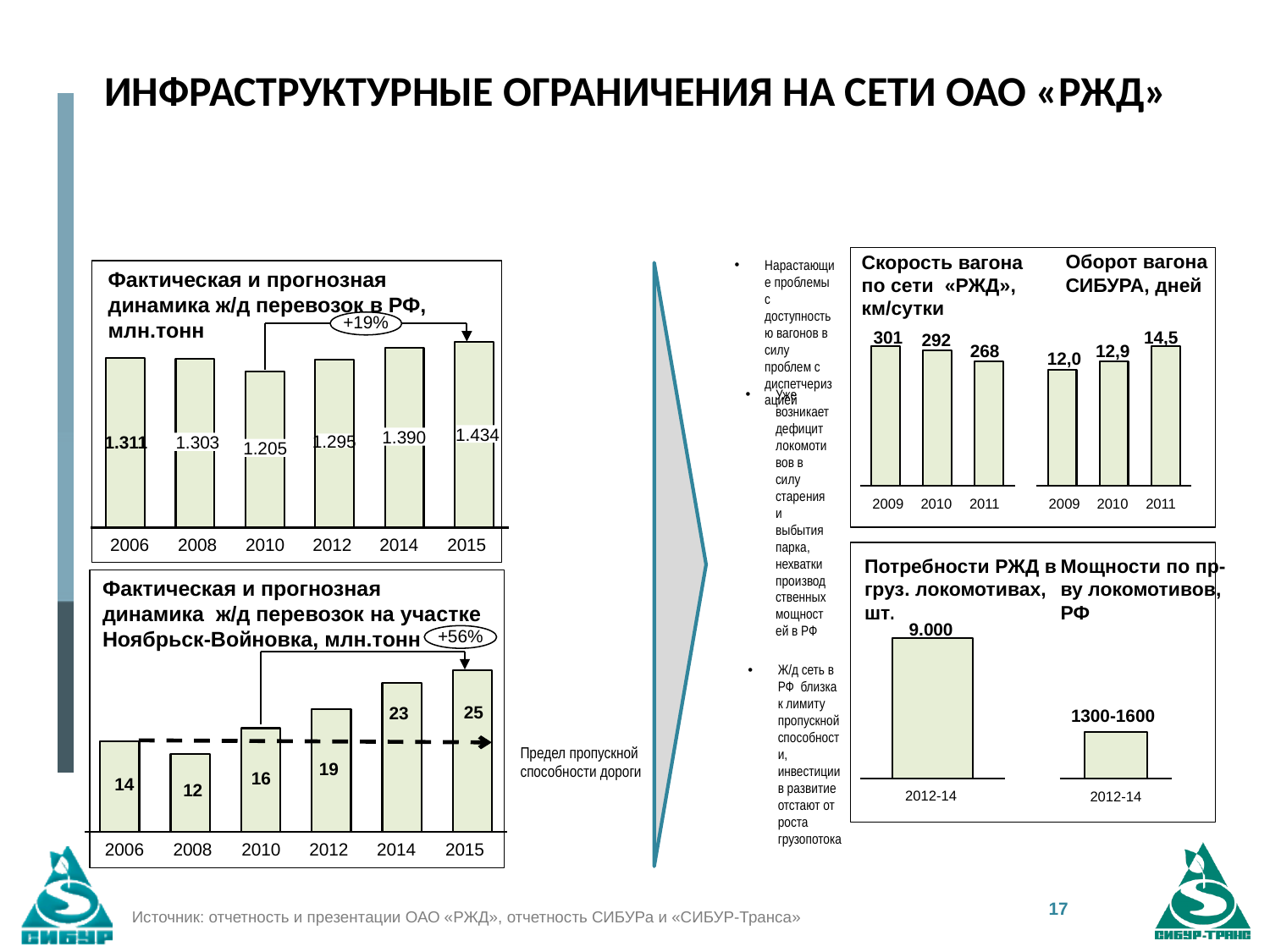
In the chart 'Фактическая и прогнозная динамика ж/д перевозок на участке Ноябрьск-Войновка, млн.тонн', how many years are shown on the x axis? 6 What kind of chart is 'Мощности по пр-ву локомотивов, РФ'? bar chart In the chart 'Оборот вагона СИБУРА, дней', which year has the highest value? 2011 In the chart 'Фактическая и прогнозная динамика ж/д перевозок на участке Ноябрьск-Войновка, млн.тонн', what is the difference between the values for 2015 and 2006? 11 In the chart 'Фактическая и прогнозная динамика ж/д перевозок в РФ, млн.тонн', which year has the lowest value? 2010 In the chart 'Скорость вагона по сети «РЖД», км/сутки', what is the value for 2011? 268 In the chart 'Фактическая и прогнозная динамика ж/д перевозок на участке Ноябрьск-Войновка, млн.тонн', what is the value for 2012? 19 In the chart 'Потребности РЖД в груз. локомотивах, шт.', what is the value for 2012-14? 9.000 In the chart 'Оборот вагона СИБУРА, дней', what is the value for 2010? 12,9 In the chart 'Фактическая и прогнозная динамика ж/д перевозок в РФ, млн.тонн', which year has the highest value? 2015 In the chart 'Скорость вагона по сети «РЖД», км/сутки', do the values rise or fall from 2009 to 2011? fall In the chart 'Фактическая и прогнозная динамика ж/д перевозок в РФ, млн.тонн', what is the value for 2010? 1.205